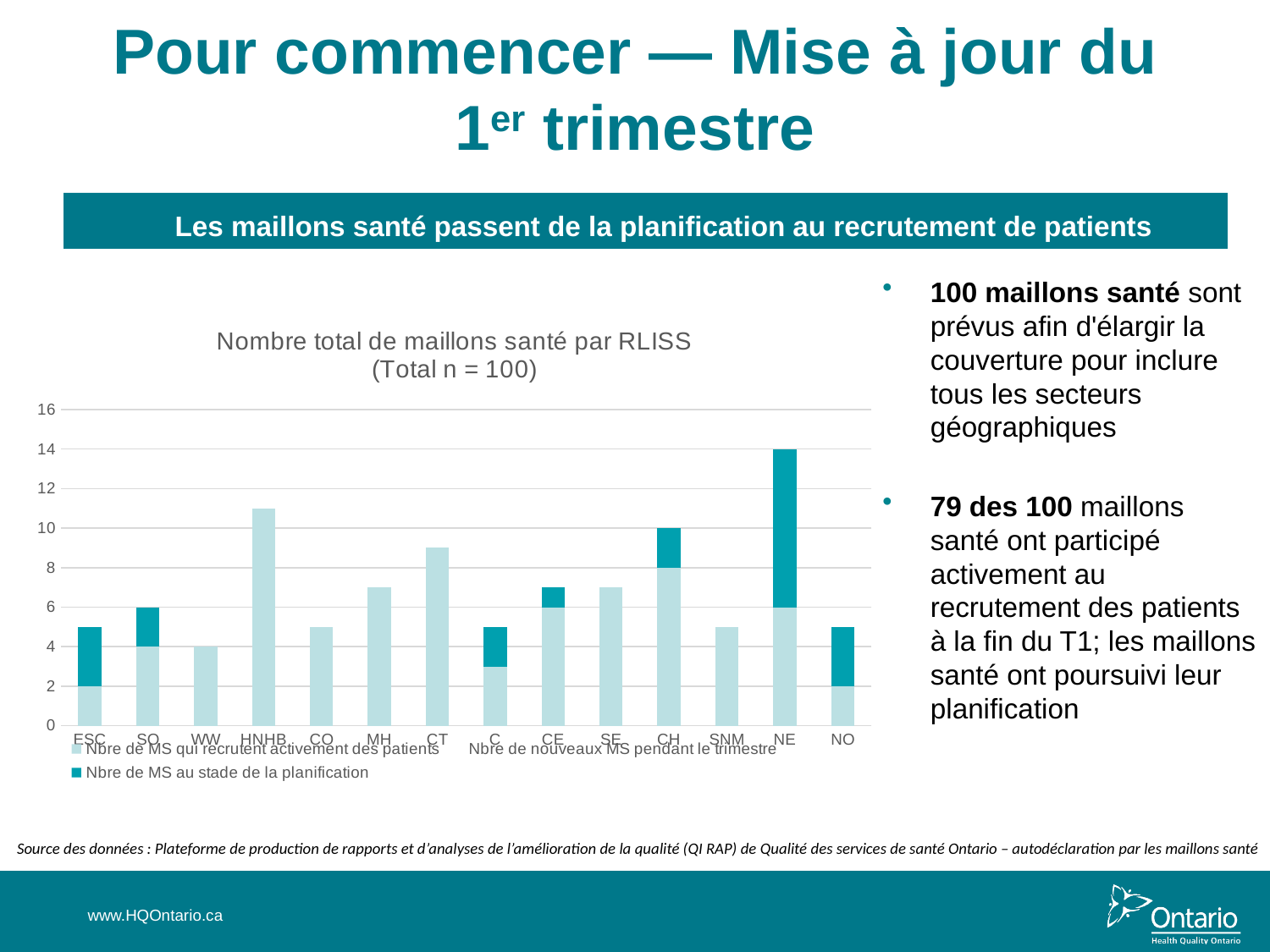
Is the total value for HNHB greater or less than 10? greater What is the total height of the bar for NE? 14 What is the title of the chart? Nombre total de maillons santé par RLISS (Total n = 100) Which has a larger total bar, NE or CH? NE What is the total height of the bar for WW? 4 What kind of chart is shown on the slide? bar chart How many series does the chart legend list? 3 How many RLISS categories are shown on the x axis of the chart? 14 Which RLISS has the highest total bar in the chart? NE What is the difference between the total bar for NE and the total bar for WW? 10 Is the total value for MH greater or less than 8? less What is the total height of the bar for CH? 10